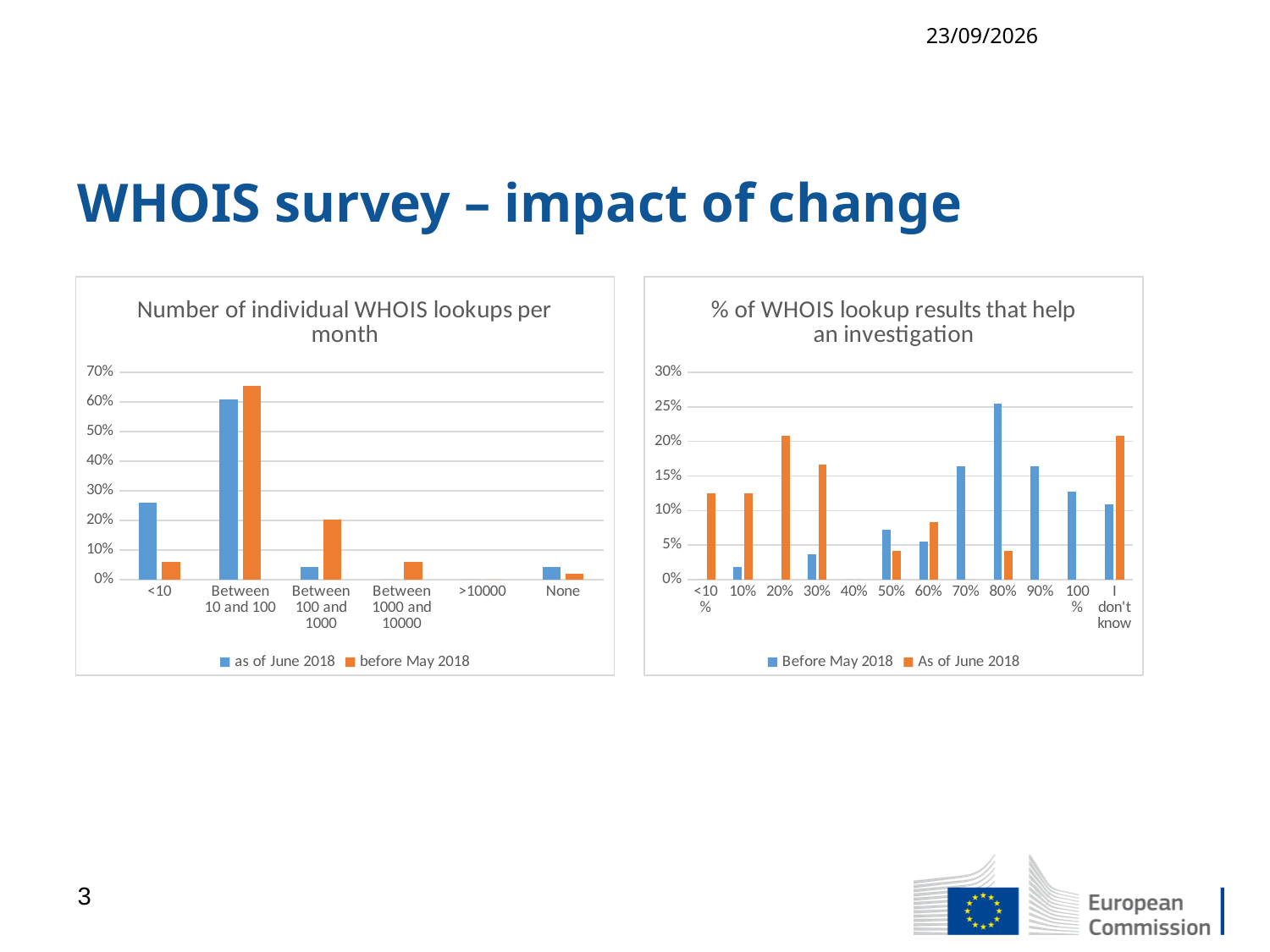
In the chart titled '% of WHOIS lookup results that help an investigation', which category has the highest value for the 'Before May 2018' series? 80% In the chart titled 'Number of individual WHOIS lookups per month', is the 'before May 2018' value for 'Between 10 and 100' greater or less than 60%? greater What type of chart is the chart titled '% of WHOIS lookup results that help an investigation'? bar chart In the chart titled '% of WHOIS lookup results that help an investigation', what colour represents the 'As of June 2018' series? orange In the chart titled 'Number of individual WHOIS lookups per month', how many series does the legend list? 2 In the chart titled 'Number of individual WHOIS lookups per month', which category has the highest value for the 'as of June 2018' series? Between 10 and 100 In the chart titled '% of WHOIS lookup results that help an investigation', which is larger for 'I don't know': 'Before May 2018' or 'As of June 2018'? As of June 2018 In the chart titled 'Number of individual WHOIS lookups per month', how many categories are shown on the x axis? 6 In the chart titled '% of WHOIS lookup results that help an investigation', how many categories are shown on the x axis? 12 In the chart titled 'Number of individual WHOIS lookups per month', is the 'as of June 2018' value for '<10' greater or less than 20%? greater In the chart titled 'Number of individual WHOIS lookups per month', which is larger for 'Between 100 and 1000': 'as of June 2018' or 'before May 2018'? before May 2018